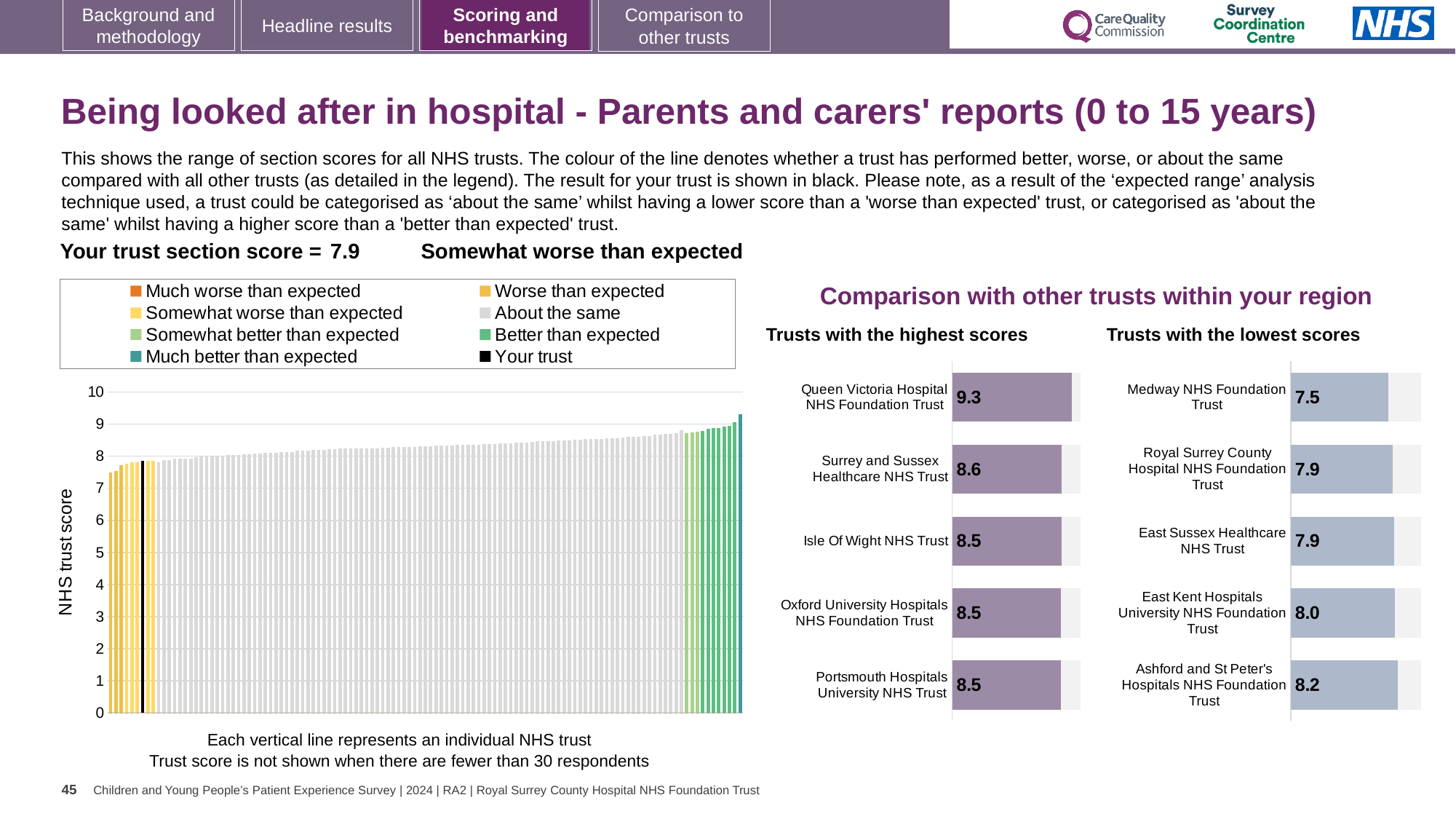
In the 'Trusts with the lowest scores' chart, which trust has the lowest score? Medway NHS Foundation Trust In the 'Trusts with the lowest scores' chart, which has the larger score: Ashford and St Peter's Hospitals NHS Foundation Trust or East Kent Hospitals University NHS Foundation Trust? Ashford and St Peter's Hospitals NHS Foundation Trust In the 'Trusts with the lowest scores' chart, what is the difference between the scores of Ashford and St Peter's Hospitals NHS Foundation Trust and Medway NHS Foundation Trust? 0.7 In the 'Trusts with the highest scores' chart, what is the score for Queen Victoria Hospital NHS Foundation Trust? 9.3 In the 'Trusts with the highest scores' chart, which trust has the highest score? Queen Victoria Hospital NHS Foundation Trust In the 'Trusts with the lowest scores' chart, what is the score for Medway NHS Foundation Trust? 7.5 In the large 'NHS trust score' chart on the left, do the values rise or fall from left to right? Rise In the large 'NHS trust score' chart on the left, what colour is used for the bar representing your trust? Black How many trusts are shown in the 'Trusts with the highest scores' chart? 5 What kind of chart is the large 'NHS trust score' chart on the left of the slide? Bar chart In the 'Trusts with the highest scores' chart, what is the difference between the scores of Queen Victoria Hospital NHS Foundation Trust and Surrey and Sussex Healthcare NHS Trust? 0.7 How many entries does the legend above the large 'NHS trust score' chart list? 8